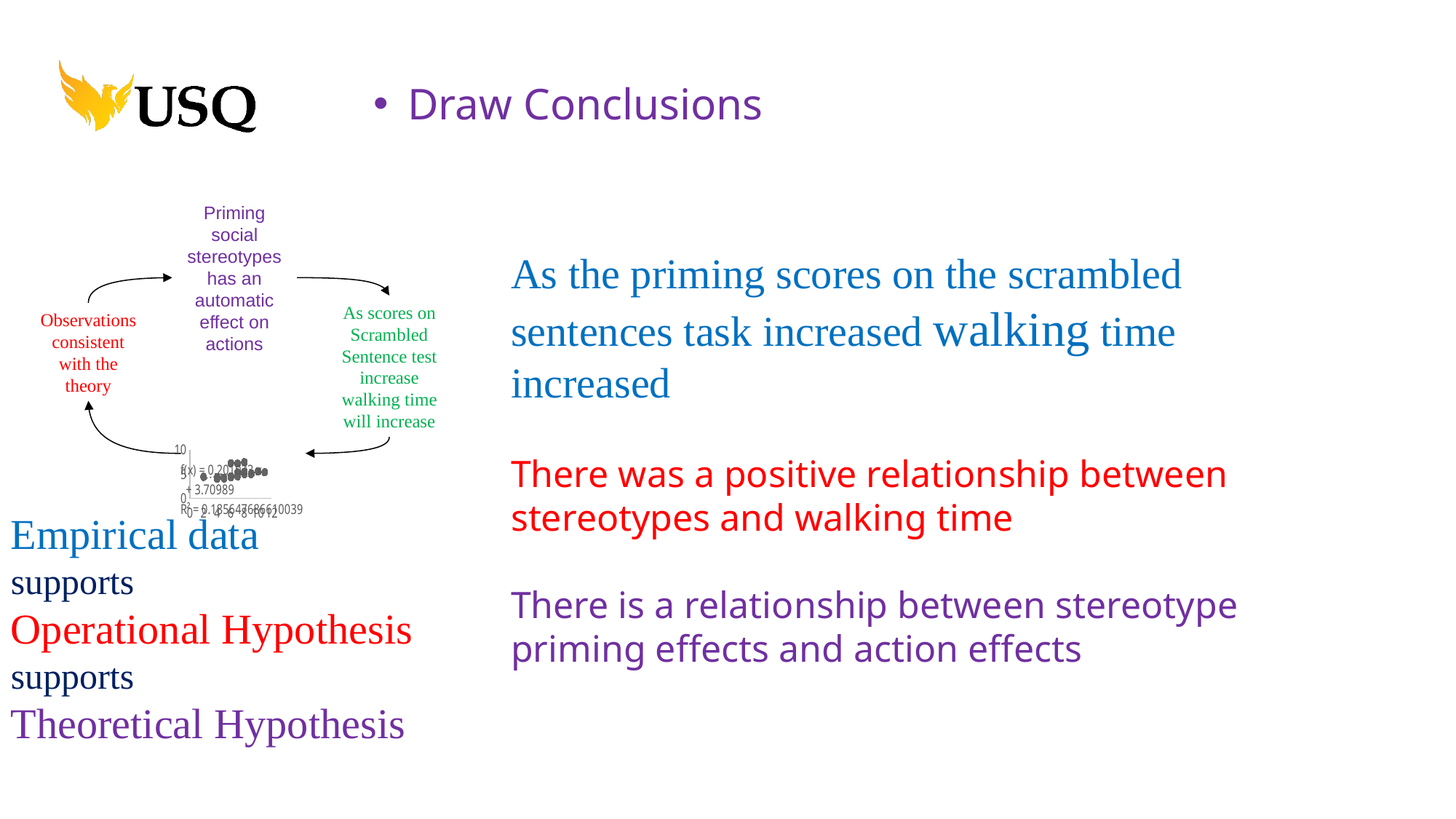
What is the highest tick value shown on the y axis of the small scatter chart? 10 What kind of chart is shown in the small chart at the bottom of the cycle diagram? scatter chart What is the highest tick value shown on the x axis of the small scatter chart? 12 In the small scatter chart, do the values tend to rise or fall as the x-axis values increase? rise